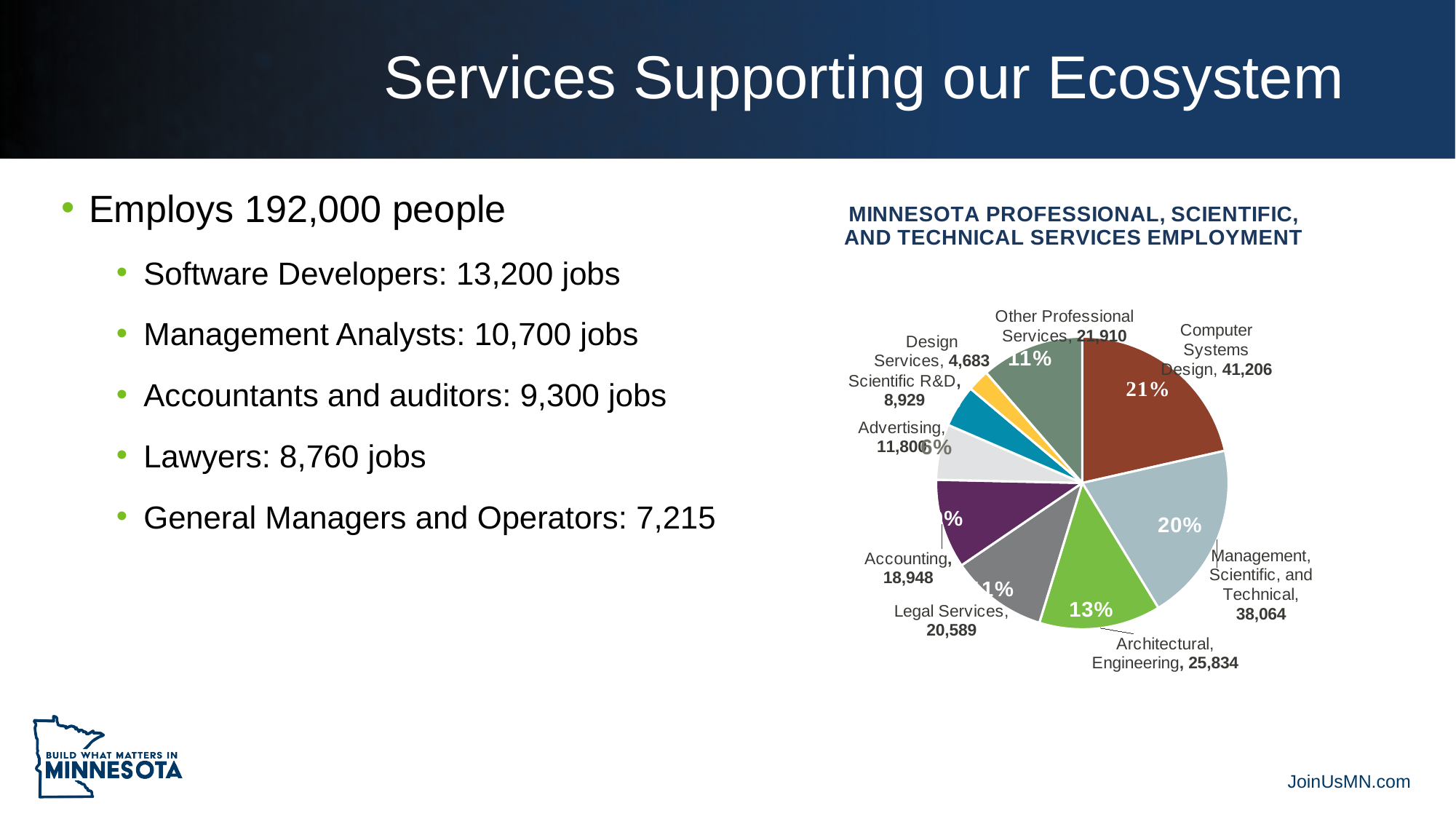
What share of the pie does Architectural, Engineering represent? 13% Which is larger, Accounting or Advertising? Accounting What is the difference between the Computer Systems Design value and the Management, Scientific, and Technical value? 3,142 Which category has the largest slice of the pie? Computer Systems Design What share of the pie does Management, Scientific, and Technical represent? 20% What is the employment value for Legal Services? 20,589 What is the employment value for Computer Systems Design? 41,206 How many slices does the pie chart have? 9 What kind of chart is shown on the slide? pie chart Which category has the smallest slice of the pie? Design Services What is the title of the chart? MINNESOTA PROFESSIONAL, SCIENTIFIC, AND TECHNICAL SERVICES EMPLOYMENT What is the employment value for Scientific R&D? 8,929